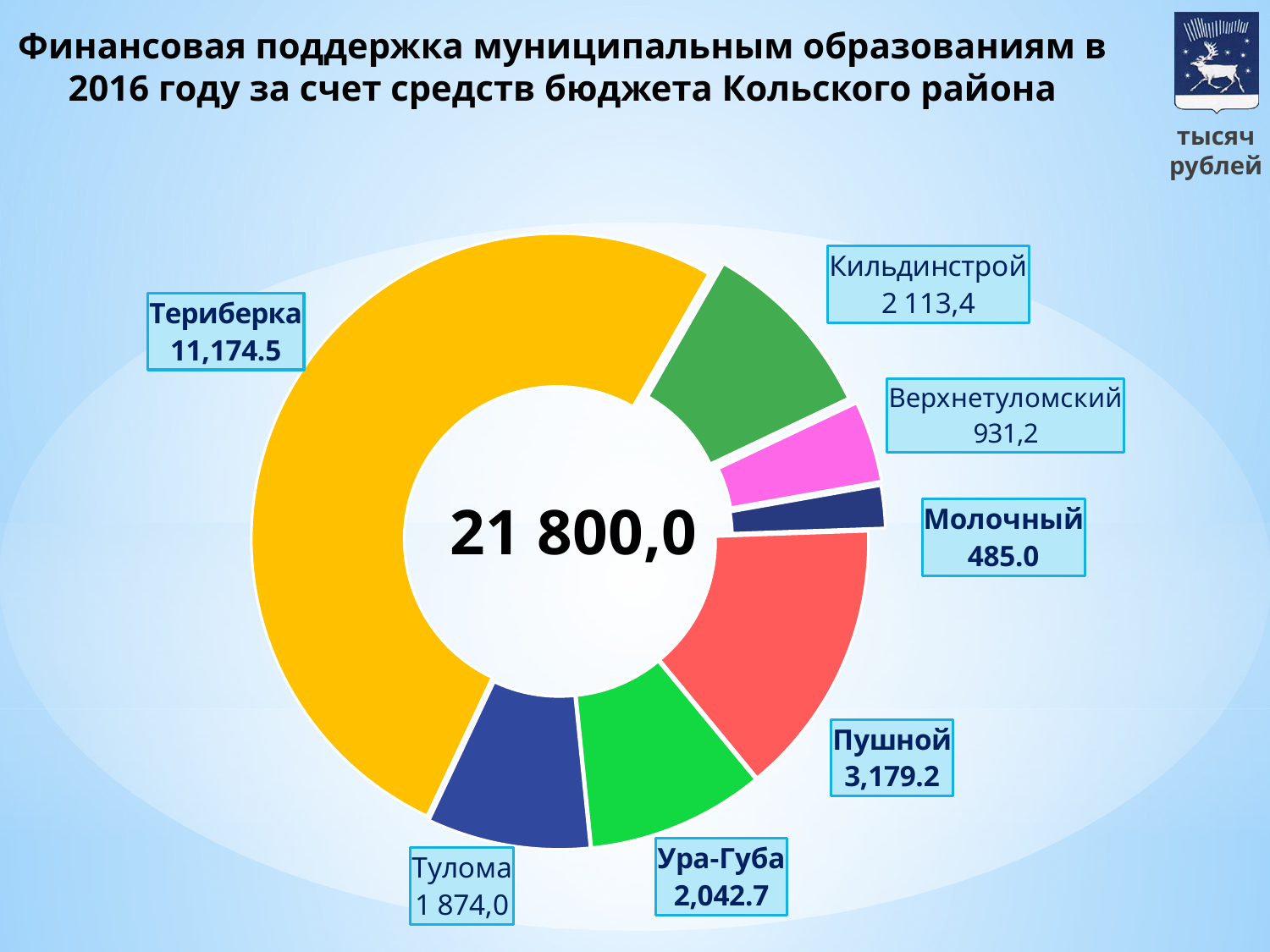
What kind of chart is shown on the slide? Pie (donut) chart What is the value shown for Кильдинстрой? 2 113,4 How many municipalities (segments) are shown in the chart? 7 What is the value shown for Териберка? 11,174.5 In what units are the values on the chart expressed, according to the slide? тысяч рублей What is the value shown for Тулома? 1 874,0 Which received more support, Пушной or Тулома? Пушной Which municipality received the largest amount of financial support? Териберка What is the value shown for Молочный? 485.0 What is the difference between the values for Пушной and Ура-Губа? 1,136.5 Which municipality received the smallest amount of financial support? Молочный What total value is shown in the centre of the chart? 21 800,0